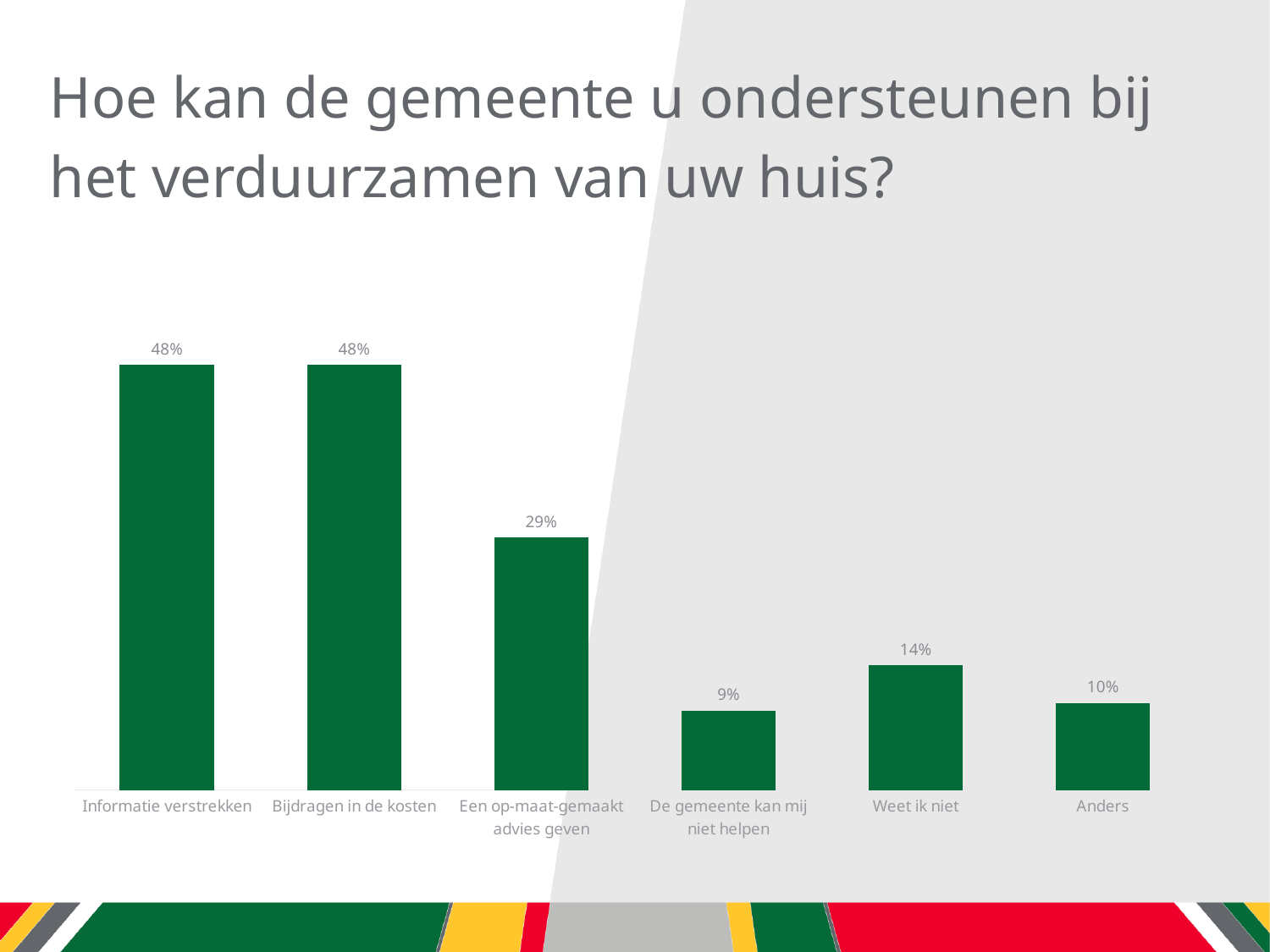
What is the title of the slide containing the chart? Hoe kan de gemeente u ondersteunen bij het verduurzamen van uw huis? Which is larger, the value for "Een op-maat-gemaakt advies geven" or the value for "De gemeente kan mij niet helpen"? Een op-maat-gemaakt advies geven What is the difference between the values for "Informatie verstrekken" and "Een op-maat-gemaakt advies geven"? 19% What is the difference between the values for "Weet ik niet" and "De gemeente kan mij niet helpen"? 5% Which category has the lowest value? De gemeente kan mij niet helpen What is the value for "Een op-maat-gemaakt advies geven"? 29% How many categories are shown in the chart? 6 Which is larger, the value for "Weet ik niet" or the value for "Anders"? Weet ik niet What is the value for "Bijdragen in de kosten"? 48% What is the value for "Anders"? 10% What kind of chart is shown on the slide? Bar chart What is the value for "Weet ik niet"? 14%